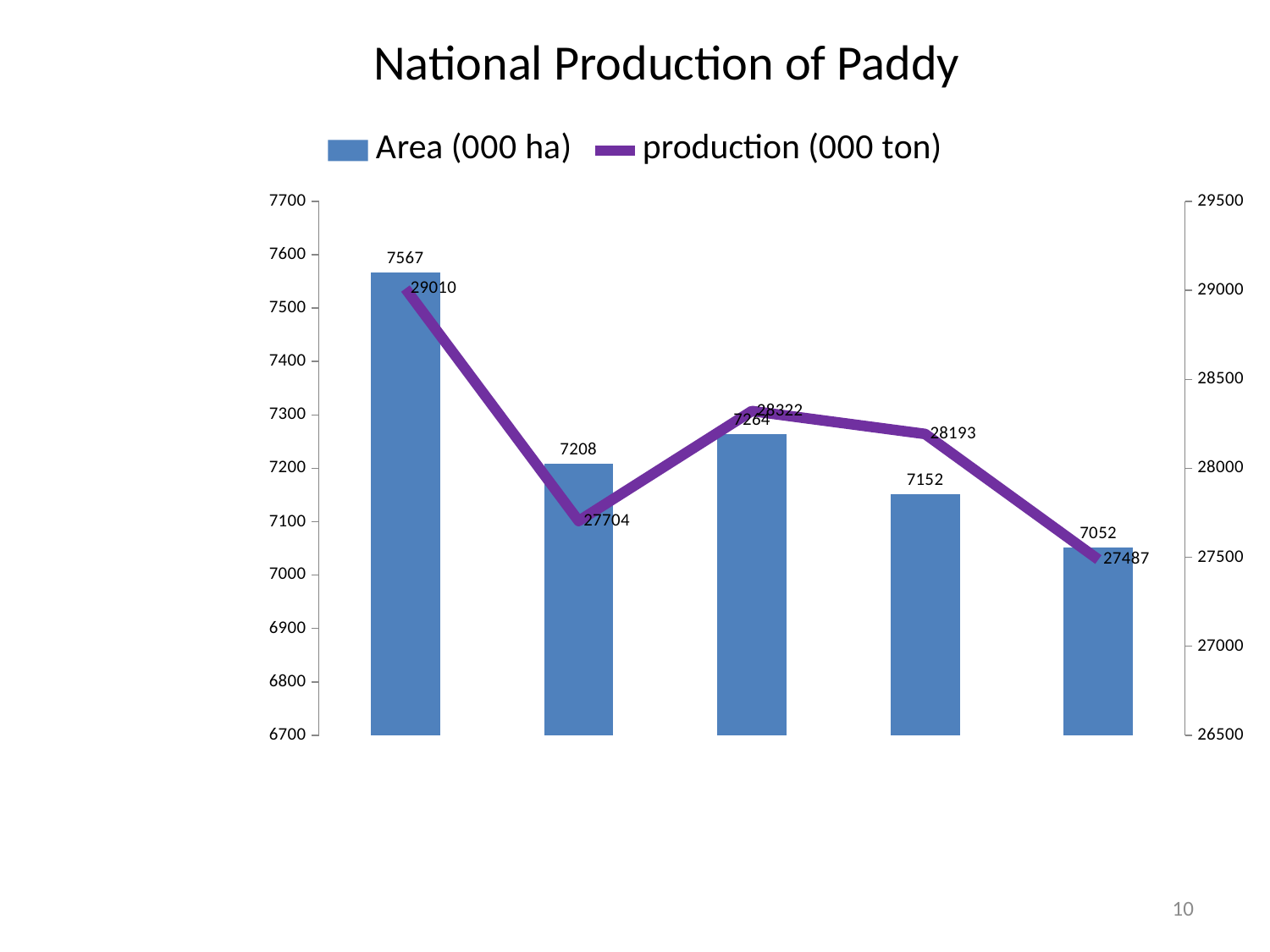
What is the value of the last (rightmost) bar for Area (000 ha)? 7052 What is the lowest production (000 ton) value shown? 27487 How many series does the legend list? 2 What is the value of the first (leftmost) bar for Area (000 ha)? 7567 What is the title of the chart? National Production of Paddy Overall, do the Area (000 ha) bars rise or fall from left to right? Fall How many bars are plotted for Area (000 ha)? 5 Which bar has the highest Area (000 ha) value? The first (leftmost) bar, 7567 What is the production (000 ton) value at the second point from the left? 27704 What is the production (000 ton) value at the fourth point from the left? 28193 What is the difference between the first and last Area (000 ha) values? 515 Which is larger, the production (000 ton) value at the third point or at the fourth point? The third point (28322)